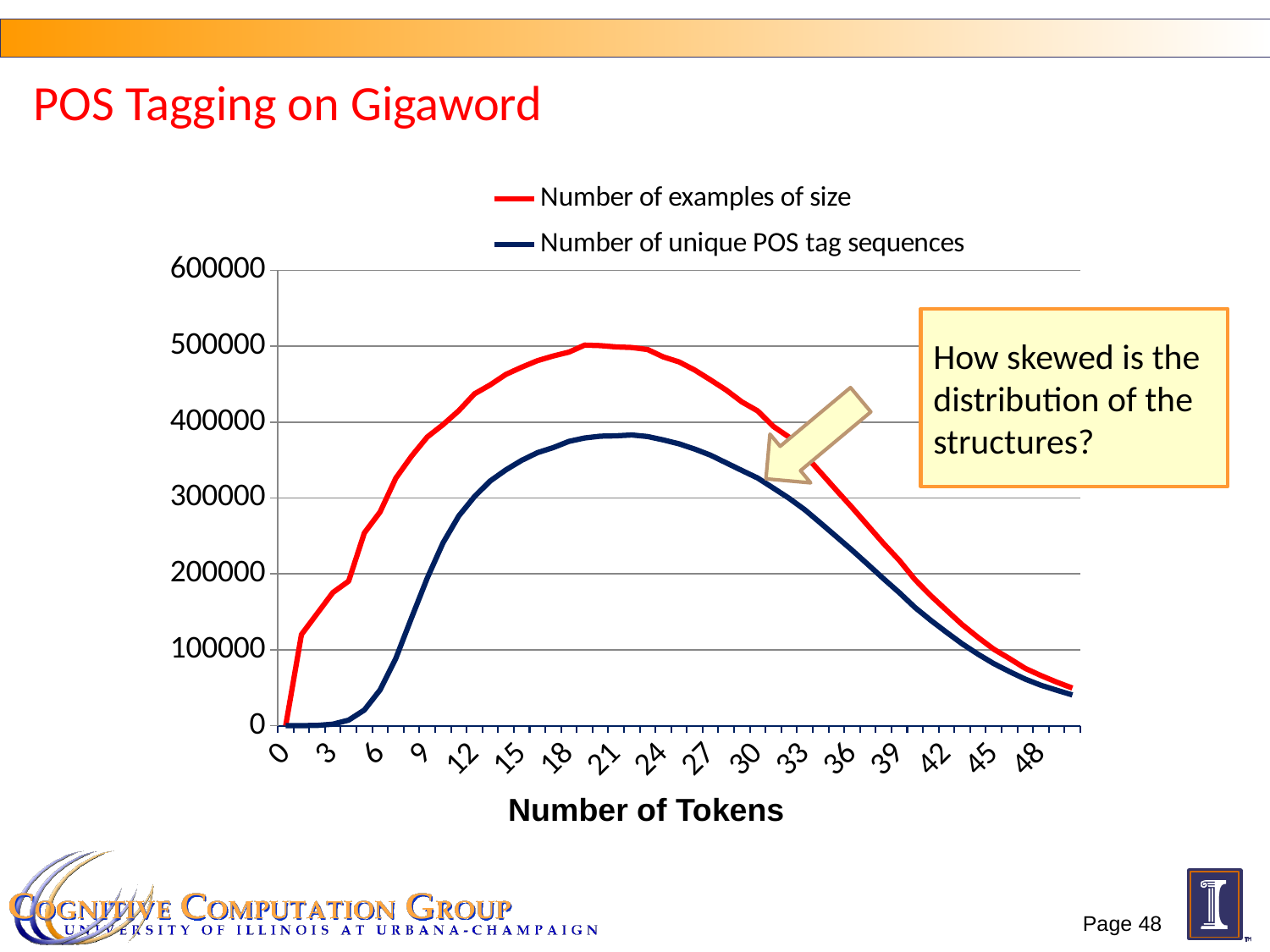
Is the value of Number of unique POS tag sequences at 6 tokens greater or less than 100000? less Do the values of Number of unique POS tag sequences rise or fall between 6 and 18 tokens? rise Which series is drawn in red? Number of examples of size At 9 tokens, which series has the larger value: Number of examples of size or Number of unique POS tag sequences? Number of examples of size How many series does the legend list? 2 What is the title of the x axis? Number of Tokens What kind of chart is shown on the slide? line chart Is the value of Number of unique POS tag sequences at 21 tokens greater or less than 400000? less Is the value of Number of examples of size at 36 tokens greater or less than 200000? greater Do the values of Number of examples of size rise or fall between 24 and 48 tokens? fall